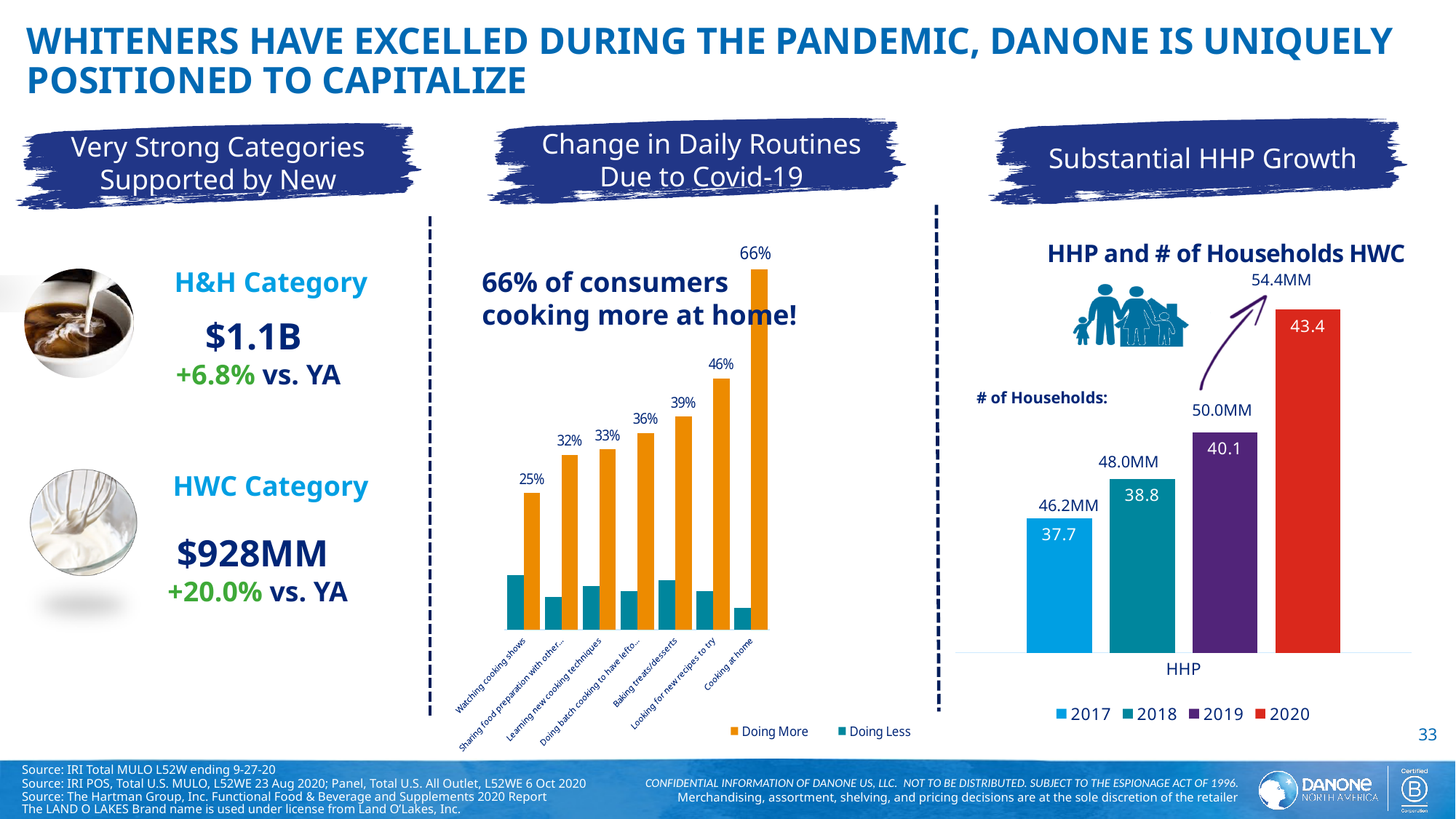
In the 'HHP and # of Households HWC' chart, what is the number of households shown for 2020? 54.4MM In the 'Change in Daily Routines Due to Covid-19' chart, which activity has the lowest Doing More value? Watching cooking shows In the 'HHP and # of Households HWC' chart, what is the HHP value for 2019? 40.1 In the 'HHP and # of Households HWC' chart, what is the difference between the HHP values for 2020 and 2017? 5.7 In the 'Change in Daily Routines Due to Covid-19' chart, what is the difference between the Doing More values for Looking for new recipes to try and Watching cooking shows? 21% In the 'Change in Daily Routines Due to Covid-19' chart, how many activities are shown on the x axis? 7 In the 'Change in Daily Routines Due to Covid-19' chart, what is the Doing More value for Baking treats/desserts? 39% In the 'HHP and # of Households HWC' chart, which year has the highest HHP value? 2020 In the 'Change in Daily Routines Due to Covid-19' chart, do the Doing More values rise or fall from left to right? rise In the 'Change in Daily Routines Due to Covid-19' chart, how many series does the legend list? 2 What kind of chart is the 'HHP and # of Households HWC' chart? bar chart In the 'Change in Daily Routines Due to Covid-19' chart, what is the Doing More value for Cooking at home? 66%